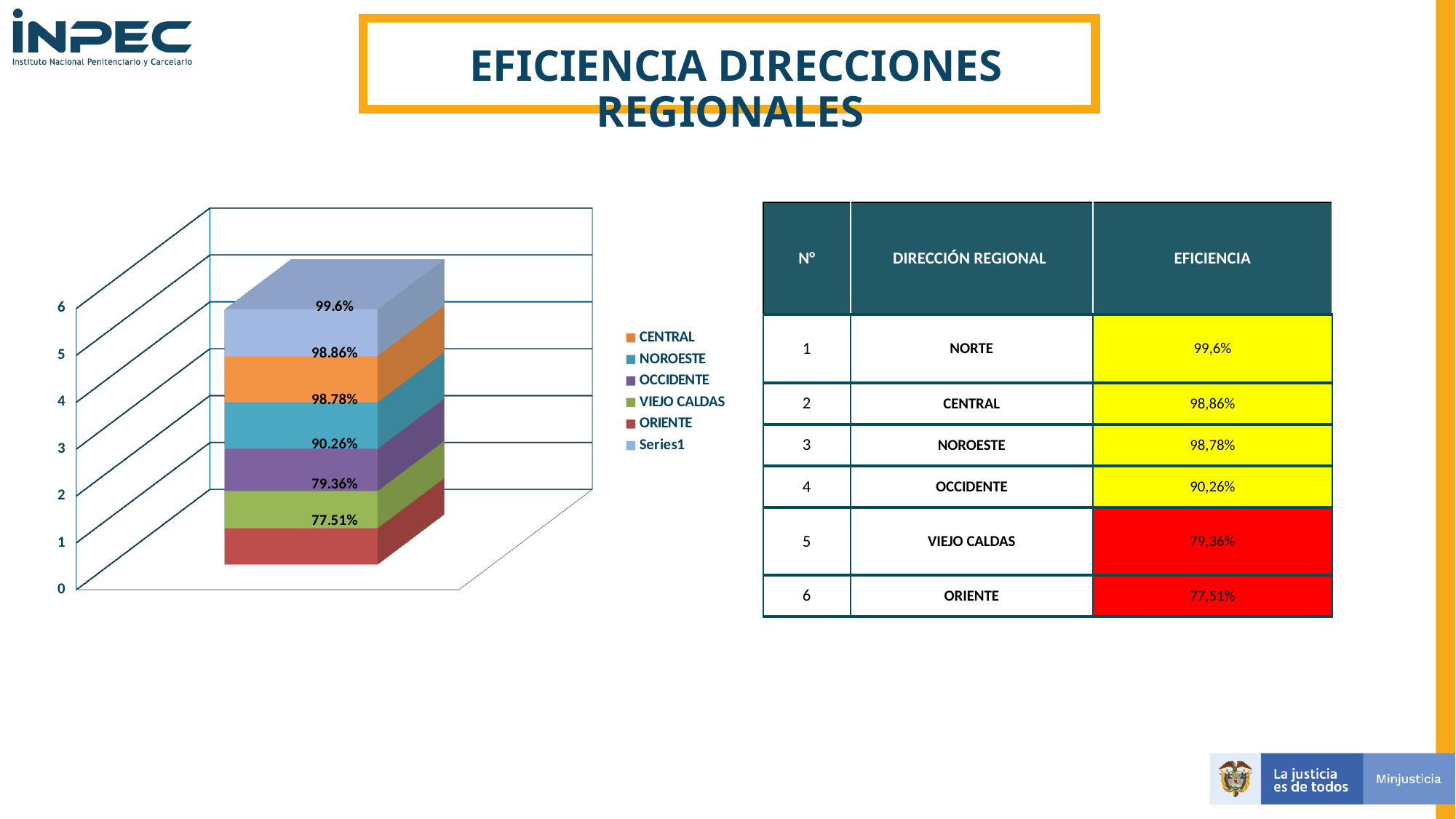
In the chart, what value is labelled on the CENTRAL segment? 98.86% In the chart, what value is labelled on the VIEJO CALDAS segment? 79.36% How many entries does the chart's legend list? 6 Which legend entry in the chart has the lowest labelled value? ORIENTE In the chart, which has the larger labelled value, OCCIDENTE or VIEJO CALDAS? OCCIDENTE In the chart, what value is labelled on the ORIENTE segment? 77.51% What colour is the ORIENTE segment in the chart? Red In the chart, what value is labelled on the Series1 segment at the top of the bar? 99.6% In the chart, what value is labelled on the OCCIDENTE segment? 90.26% What kind of chart is shown on the left of the slide? Stacked bar chart In the chart, what value is labelled on the NOROESTE segment? 98.78% What is the difference between the highest labelled value (99.6%) and the lowest labelled value (77.51%) in the chart? 22.09%